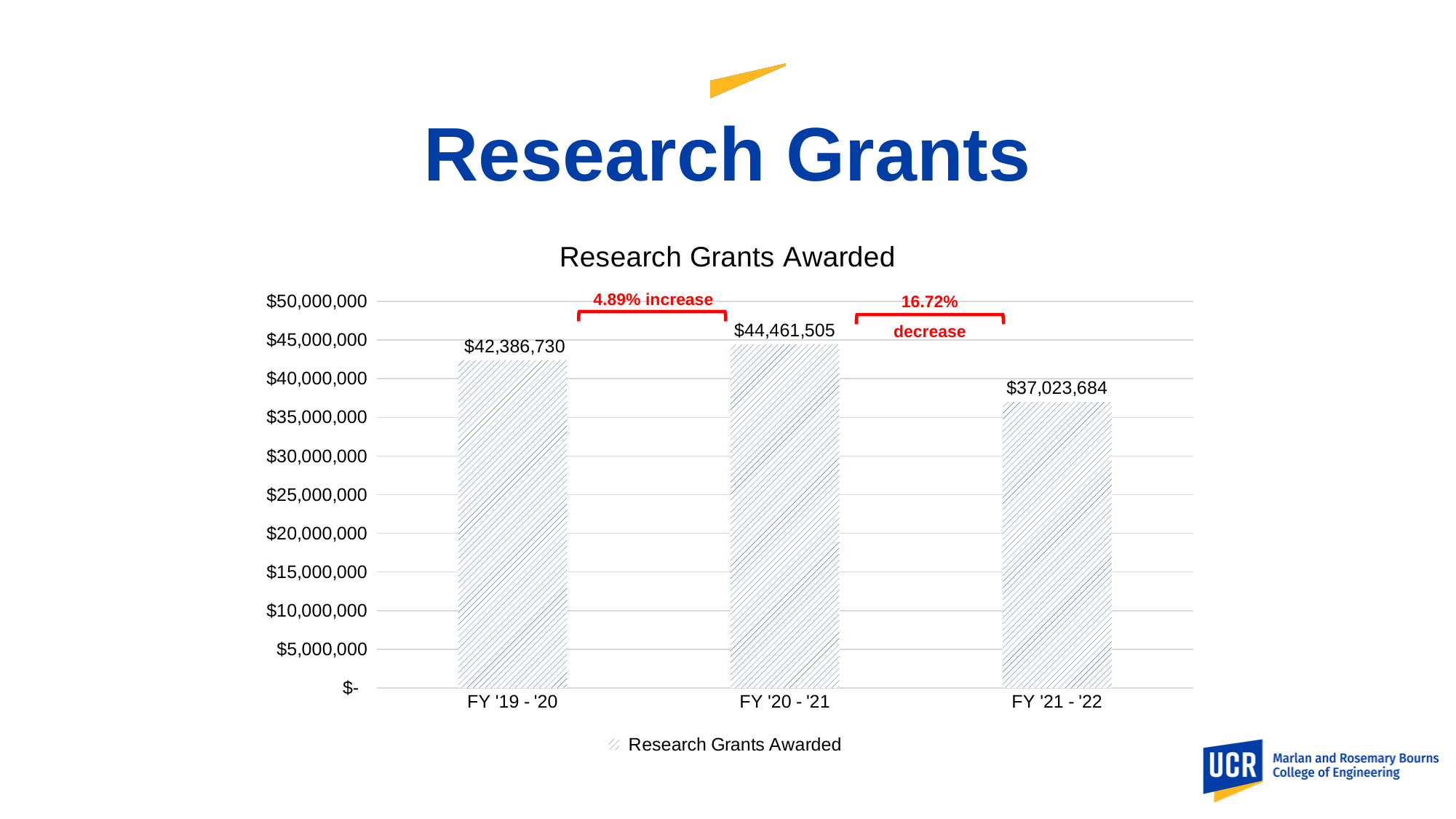
What is the difference between the values for FY '20 - '21 and FY '19 - '20? $2,074,775 Which fiscal year has the highest research grants awarded? FY '20 - '21 What kind of chart is shown on the slide? Bar chart What is the value for FY '19 - '20? $42,386,730 How many fiscal years are shown on the chart? 3 Is the value for FY '21 - '22 greater or less than $40,000,000? less What is the difference between the values for FY '20 - '21 and FY '21 - '22? $7,437,821 Which fiscal year has the lowest research grants awarded? FY '21 - '22 What is the value for FY '21 - '22? $37,023,684 What percentage change is annotated between FY '20 - '21 and FY '21 - '22? 16.72% decrease What is the value for FY '20 - '21? $44,461,505 Which is larger, the value for FY '19 - '20 or FY '21 - '22? FY '19 - '20